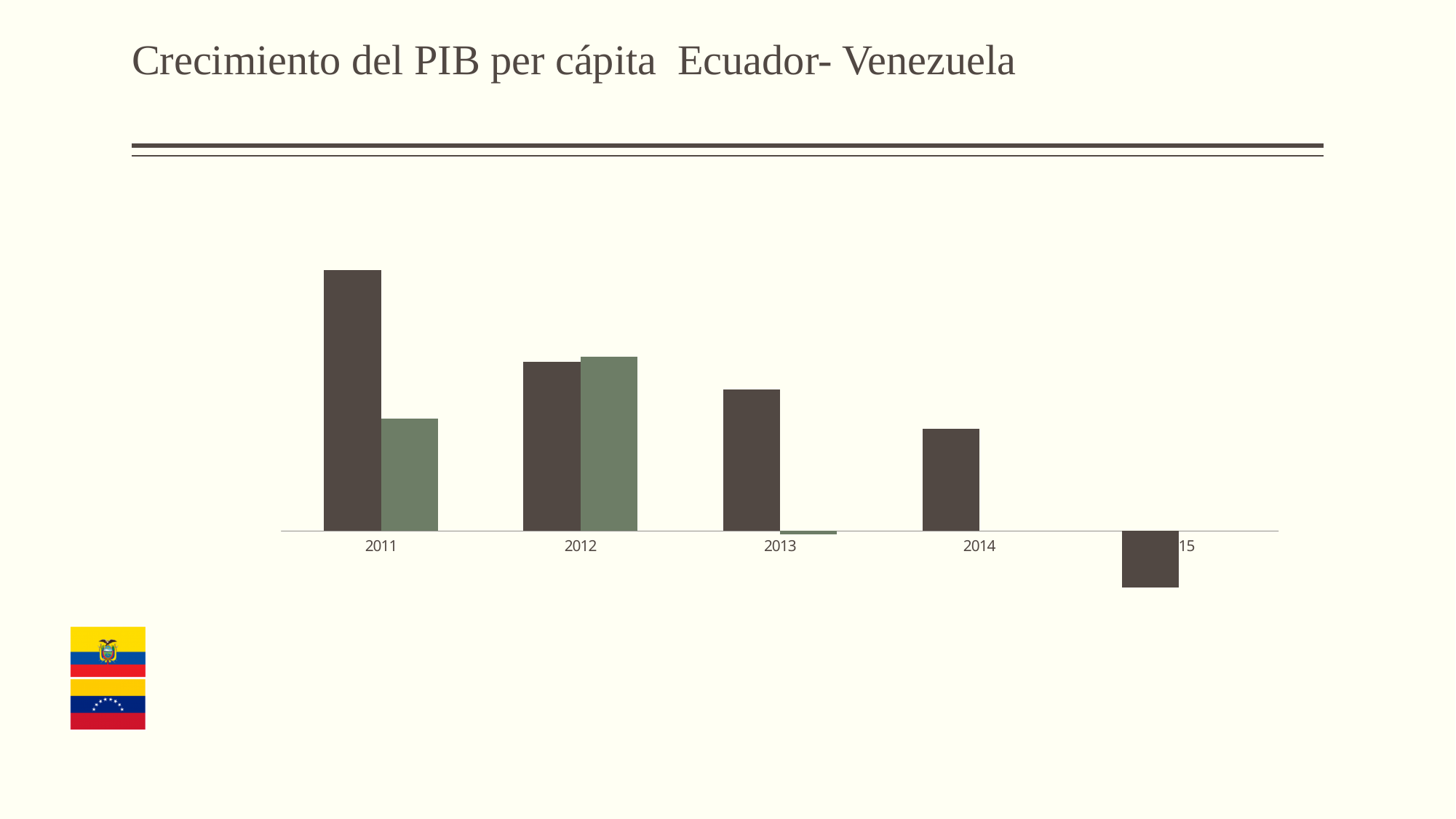
In 2013, which bar is taller, the dark brown bar or the green bar? the dark brown bar What is the title of the chart on the slide? Crecimiento del PIB per cápita Ecuador- Venezuela Which is the only year in which the dark brown bar extends below the x axis? 2015 How many years are shown on the x axis of the chart? 5 Which year has the lowest dark brown bar? 2015 In 2011, which bar is taller, the dark brown bar or the green bar? the dark brown bar Which year has the tallest dark brown bar? 2011 What kind of chart is shown on the slide? bar chart How many different bar colours are plotted in the chart? 2 Do the dark brown bars rise or fall from 2011 to 2015? fall Is the dark brown bar for 2014 taller or shorter than the dark brown bar for 2013? shorter Which year has the tallest green bar? 2012